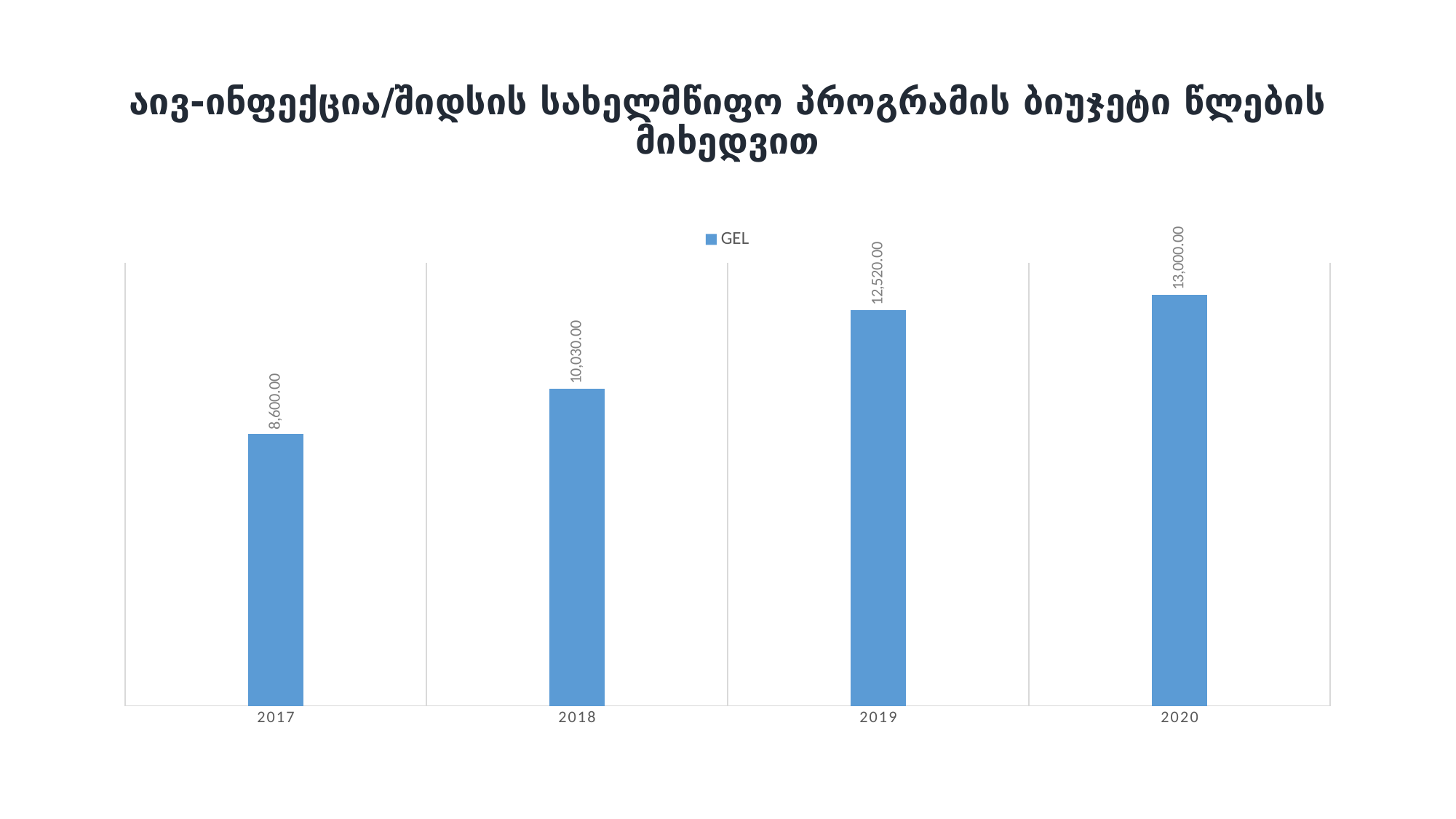
What is the value for 2017? 8,600.00 What is the value for 2018? 10,030.00 Which year has the highest value? 2020 How many years are shown on the x axis? 4 What is the difference between the values for 2019 and 2018? 2,490.00 What is the value for 2019? 12,520.00 What is the difference between the values for 2020 and 2017? 4,400.00 Which year has the lowest value? 2017 How many series does the legend list? 1 What kind of chart is this? bar chart Which is larger, the value for 2018 or the value for 2019? 2019 What is the value for 2020? 13,000.00